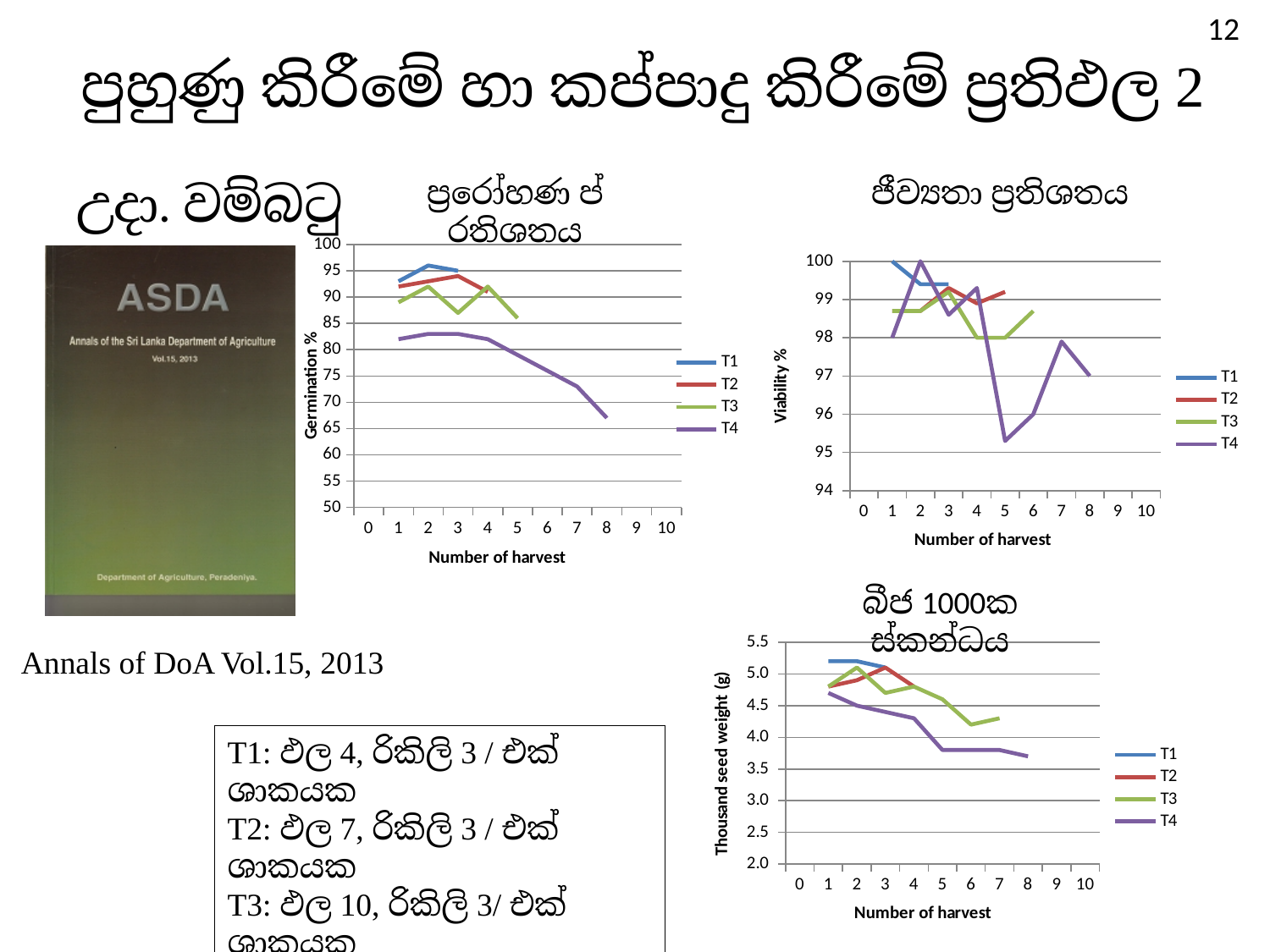
What are the legend entries of the bottom 'Thousand seed weight (g)' chart? T1, T2, T3, T4 In the top-left 'Germination %' chart, is the value for T4 at harvest 8 greater or less than 70? less In the bottom 'Thousand seed weight (g)' chart, which is larger at harvest 1: T1 or T4? T1 What is the x-axis label of the top-right 'Viability %' chart? Number of harvest In the top-right 'Viability %' chart, what is the value for T1 at harvest 1? 100 In the top-right 'Viability %' chart, what is the value for T4 at harvest 8? 97 How many series does the legend of the top-left 'Germination %' chart list? 4 In the top-left 'Germination %' chart, which series has the lowest values across the harvests? T4 In the top-left 'Germination %' chart, do the values for T4 rise or fall as the number of harvest increases? fall What kind of chart is the top-left chart with the y-axis labelled 'Germination %'? line chart In the bottom chart with the y-axis labelled 'Thousand seed weight (g)', is the value for T4 at harvest 8 greater or less than 4.0? less In the top-right 'Viability %' chart, is the value for T4 at harvest 5 greater or less than 96? less